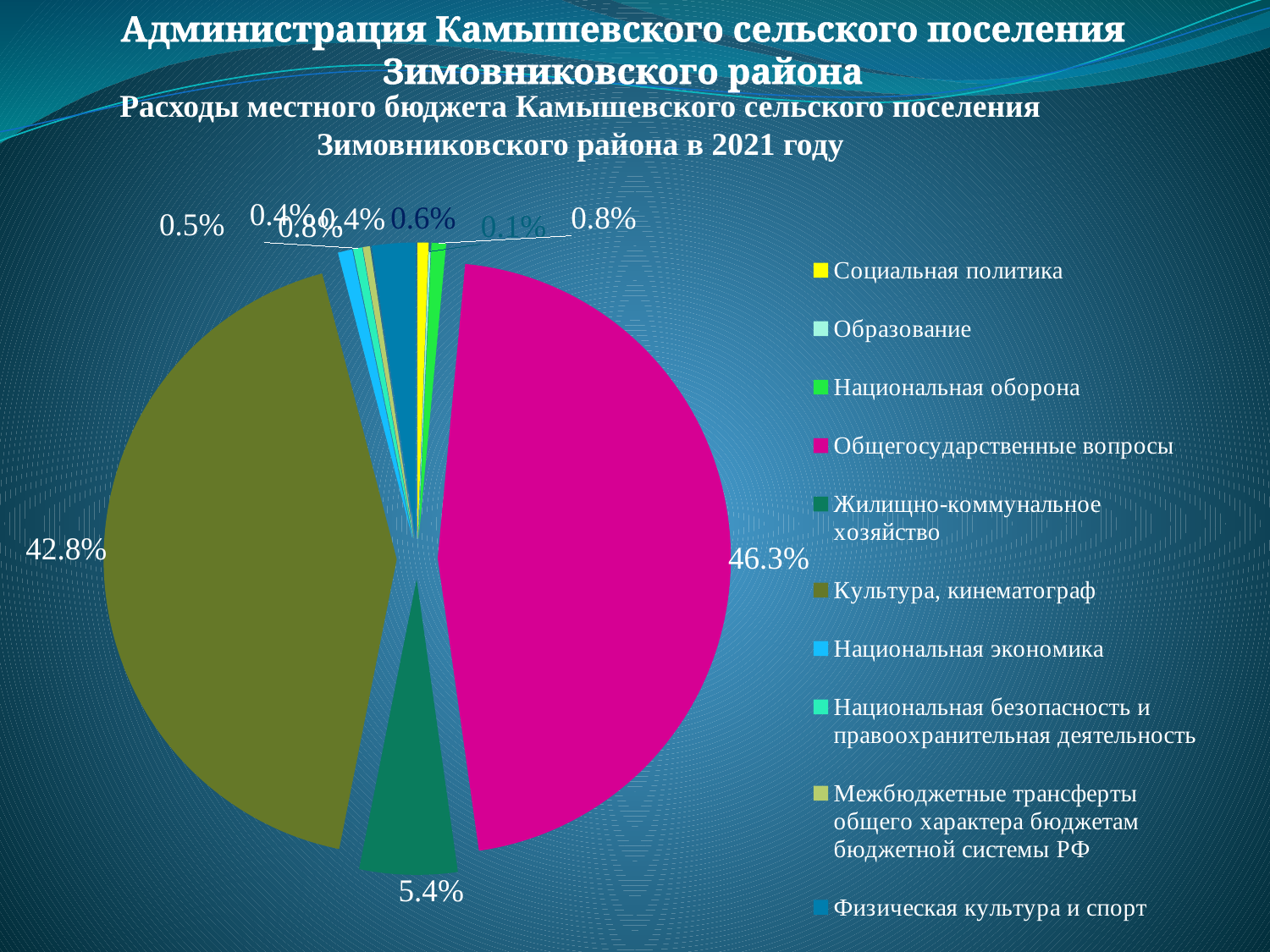
What type of chart is shown on the slide? Pie chart By how many percentage points does the share for Общегосударственные вопросы exceed that for Культура, кинематограф? 3.5 percentage points What is the combined share of the two largest slices, Общегосударственные вопросы and Культура, кинематограф? 89.1% How many expenditure categories does the legend list? 10 What share of expenditure is labelled for Культура, кинематограф? 42.8% What share of the 2021 local budget expenditure goes to Общегосударственные вопросы? 46.3% What colour is the slice for Общегосударственные вопросы? Magenta (pink) What percentage is shown for Жилищно-коммунальное хозяйство? 5.4% Which expenditure category has the largest share of the pie? Общегосударственные вопросы Which is larger: the share for Общегосударственные вопросы or for Культура, кинематограф? Общегосударственные вопросы Which is larger: the share for Жилищно-коммунальное хозяйство or for Культура, кинематограф? Культура, кинематограф What is the difference between the shares for Культура, кинематограф and Жилищно-коммунальное хозяйство? 37.4 percentage points